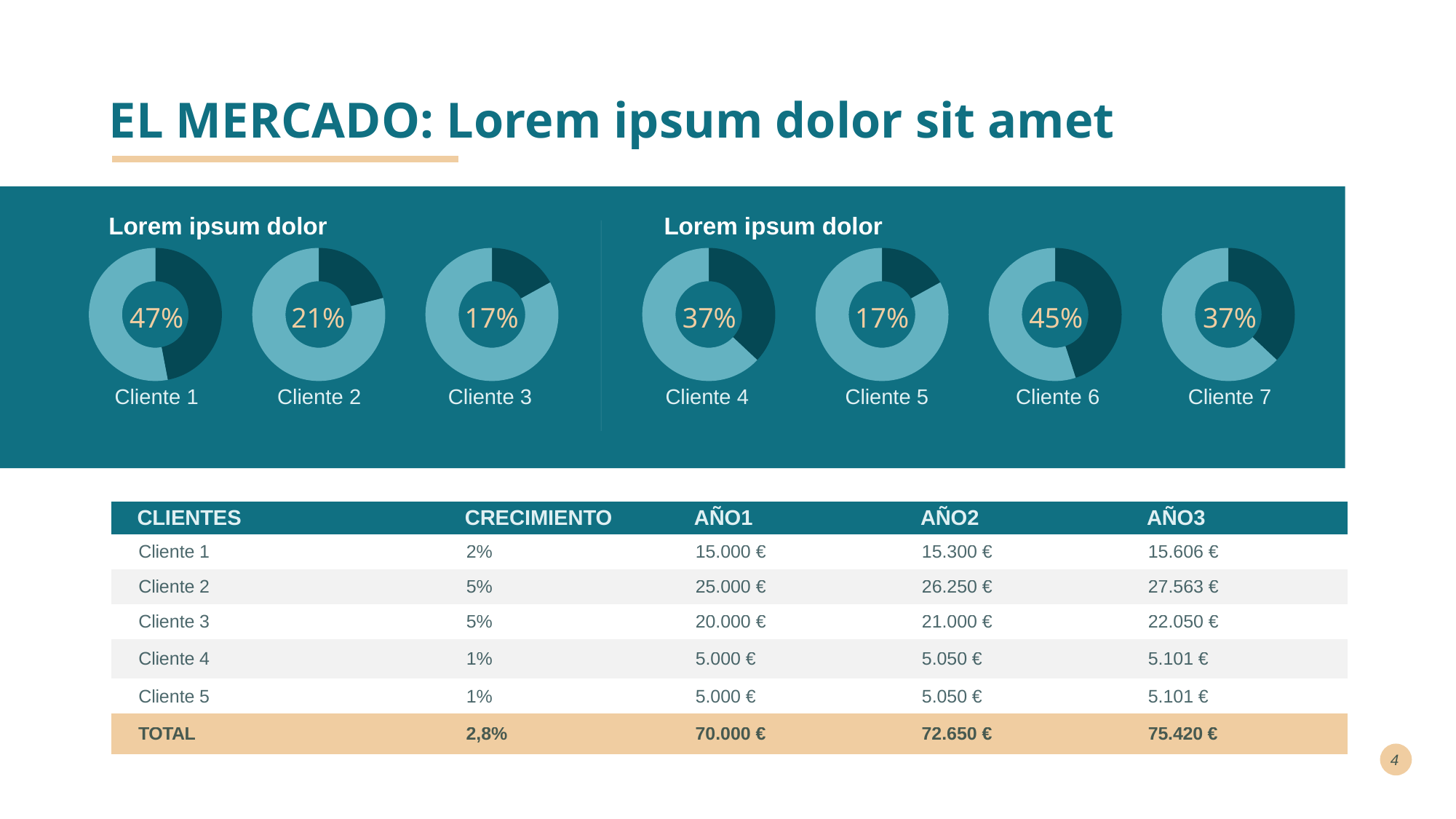
Among the four donut charts in the right group (Cliente 4 to Cliente 7), which client shows the highest percentage? Cliente 6 Among the seven donut charts, which client shows the highest percentage? Cliente 1 What value is shown in the centre of the Cliente 4 donut chart? 37% How many donut charts are shown on the slide in total? 7 What kind of chart is used to display the percentage for each client? Donut chart Among the three donut charts in the left group (Cliente 1 to Cliente 3), which client shows the lowest percentage? Cliente 3 Which shows a larger percentage, the Cliente 6 donut chart or the Cliente 7 donut chart? Cliente 6 What value is shown in the centre of the Cliente 2 donut chart? 21% What value is shown in the centre of the Cliente 1 donut chart? 47% What is the difference between the percentage shown for Cliente 1 and the percentage shown for Cliente 2? 26% Do the Cliente 3 and Cliente 5 donut charts show the same percentage? Yes, 17% What value is shown in the centre of the Cliente 6 donut chart? 45%